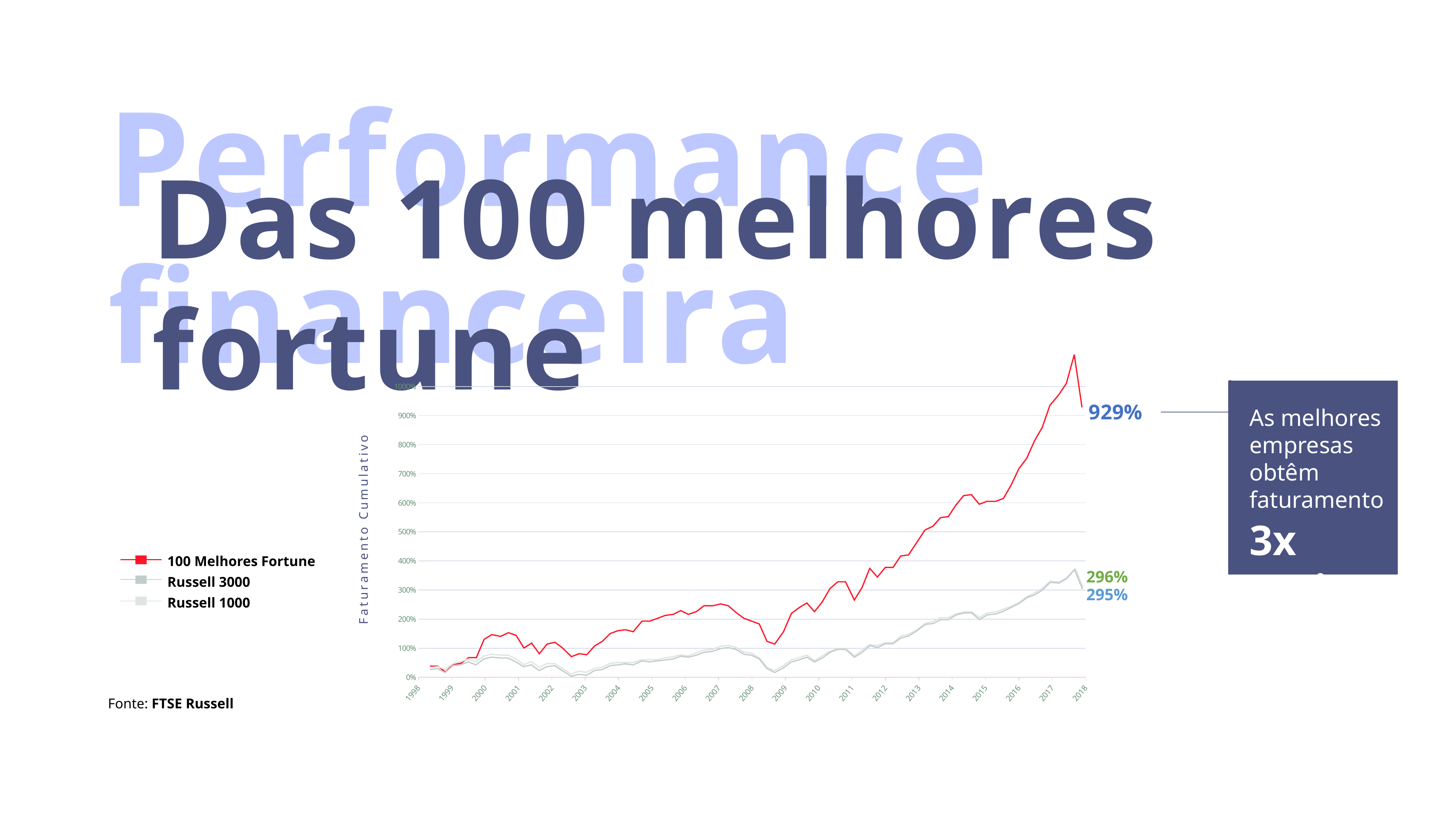
Which series are listed in the chart legend? 100 Melhores Fortune, Russell 3000, Russell 1000 In 2018, which is larger: 100 Melhores Fortune or Russell 3000? 100 Melhores Fortune What is the final value labelled for the 100 Melhores Fortune series? 929% Does the 100 Melhores Fortune line rise or fall overall from 1998 to 2018? Rise Is the value for 100 Melhores Fortune in 2015 greater or less than 500%? greater How many year labels are shown on the x axis? 21 Which series ends at the highest value in 2018? 100 Melhores Fortune What is the difference between the 929% end label and the 296% end label? 633% How many series does the chart legend list? 3 What type of chart is shown on the slide? Line chart Is the value for 100 Melhores Fortune in 2009 greater or less than 200%? less What is the title of the vertical axis? Faturamento Cumulativo